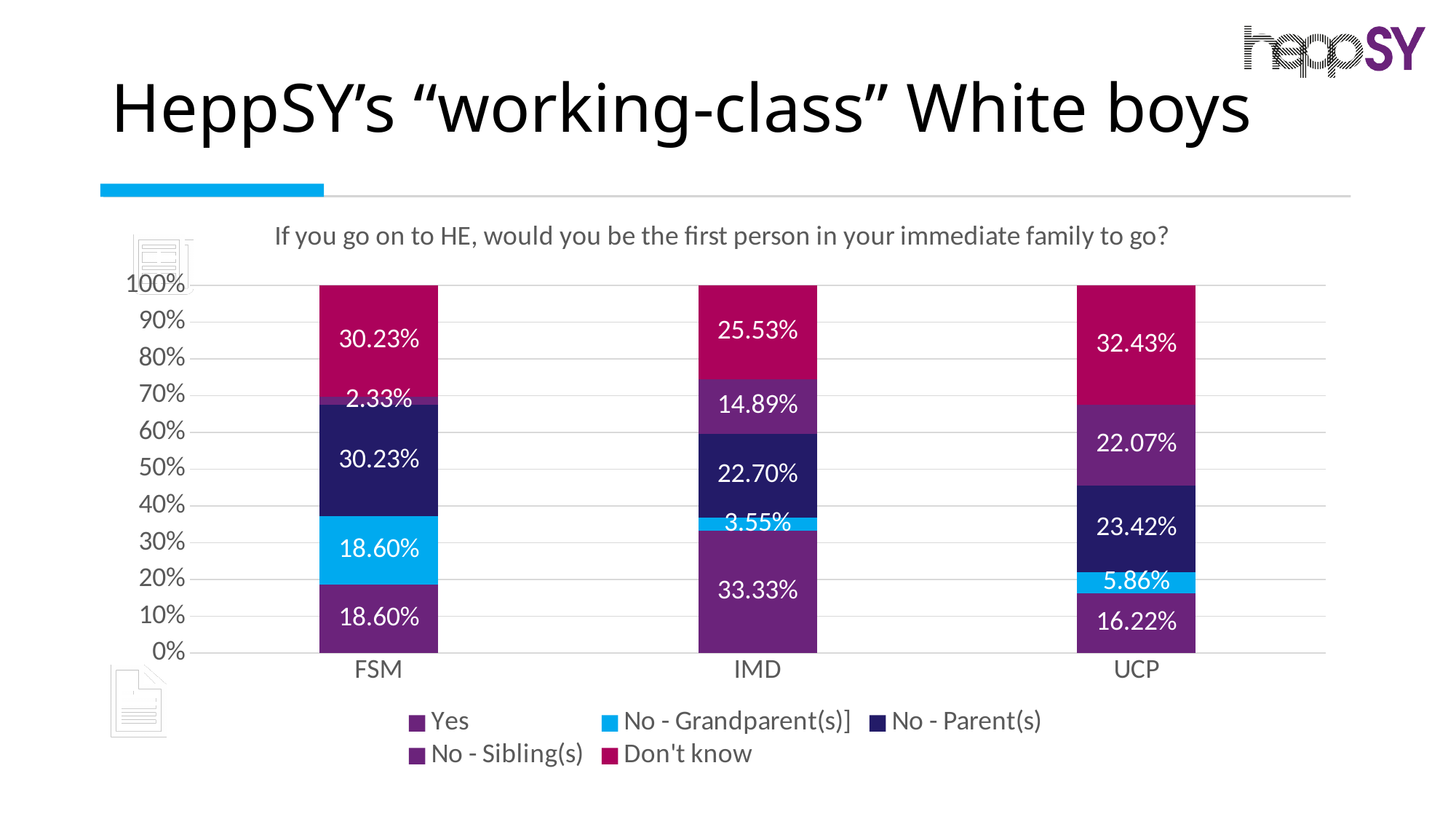
What is the value for "Don't know" in the UCP bar? 32.43% What is the difference between the "Don't know" values for UCP and IMD? 6.90% What is the value for "No - Grandparent(s)]" in the UCP bar? 5.86% What is the value for "Yes" in the IMD bar? 33.33% Which category has the highest "Yes" value? IMD How many series does the legend list? 5 How many categories are shown on the x axis? 3 Which category has the lowest "No - Grandparent(s)]" value? IMD What is the title of the chart? If you go on to HE, would you be the first person in your immediate family to go? Which is larger: the "No - Parent(s)" value for FSM or for UCP? FSM What kind of chart is shown on the slide? Stacked bar chart What is the value for "No - Sibling(s)" in the FSM bar? 2.33%